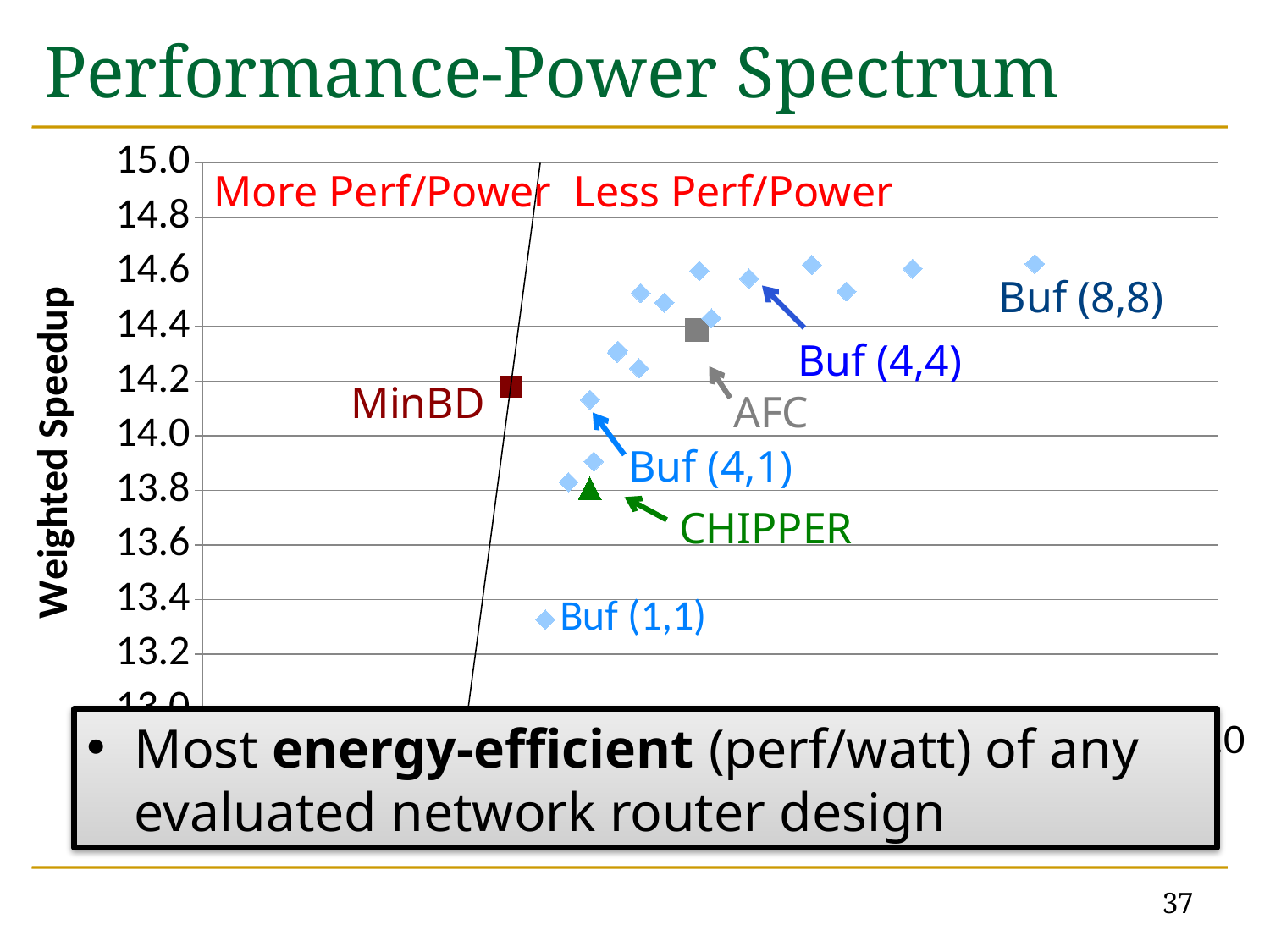
Is the weighted speedup for Buf (1,1) greater or less than 13.4? less Is the weighted speedup for AFC greater or less than 14.2? greater Which labeled design has the lowest weighted speedup? Buf (1,1) Which has the higher weighted speedup, Buf (8,8) or Buf (1,1)? Buf (8,8) Is the weighted speedup for CHIPPER greater or less than 14.0? less Which has the higher weighted speedup, AFC or MinBD? AFC What kind of chart is shown on the slide? scatter chart Which design is marked with a green triangle? CHIPPER What is the title of the vertical axis? Weighted Speedup Which has the higher weighted speedup, MinBD or CHIPPER? MinBD